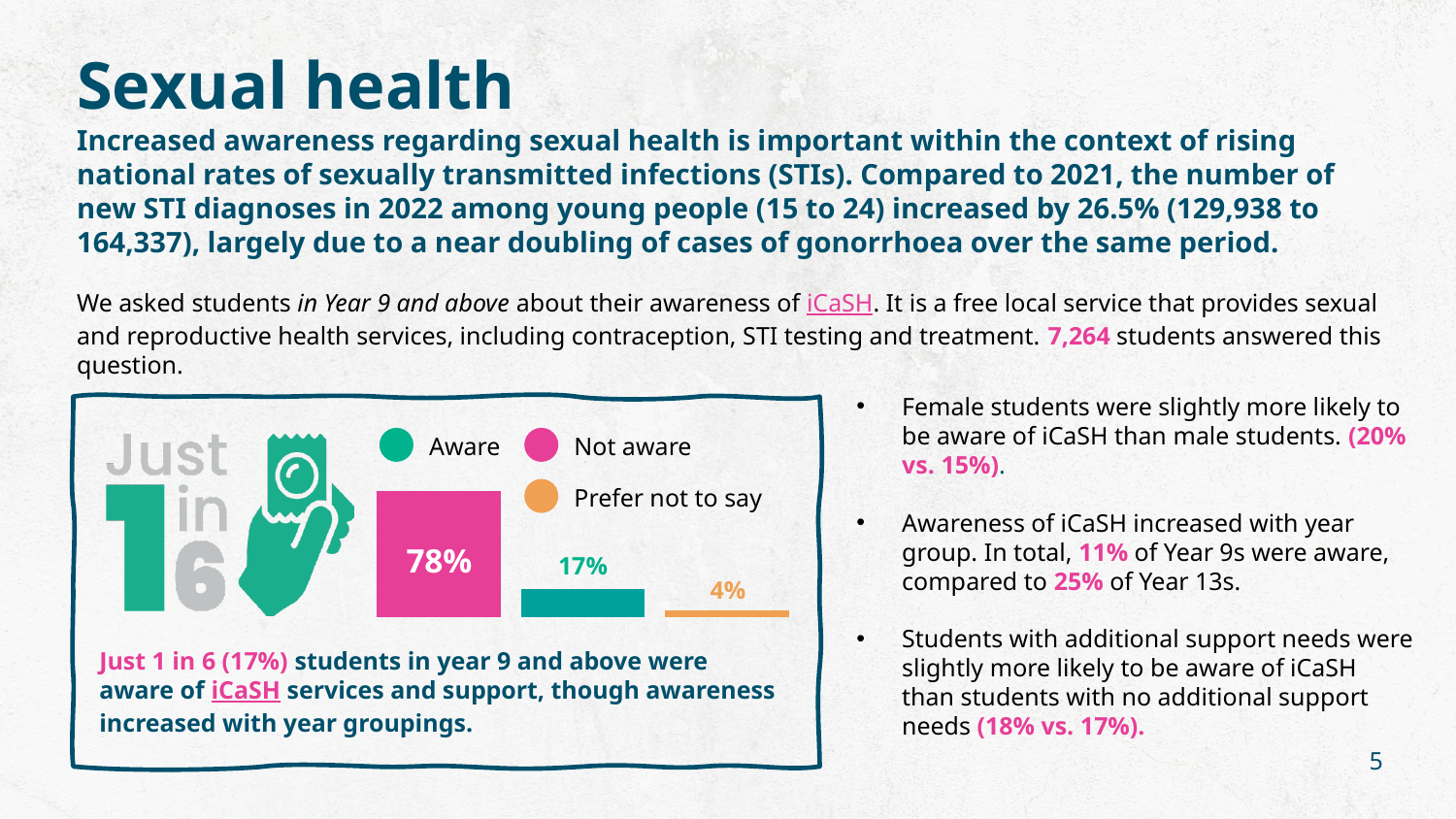
How many entries does the legend of the bar chart list? 3 What percentage of students answered 'Prefer not to say' in the bar chart? 4% How many categories are shown in the bar chart? 3 What percentage of students were aware of iCaSH according to the bar chart? 17% What percentage of students were not aware of iCaSH according to the bar chart? 78% What type of chart is used to show iCaSH awareness on the slide? Bar chart Which is larger in the bar chart, 'Aware' or 'Not aware'? Not aware Which category has the highest value in the bar chart? Not aware What colour represents 'Prefer not to say' in the bar chart legend? Orange Which category has the lowest value in the bar chart? Prefer not to say What is the difference between the 'Aware' and 'Prefer not to say' percentages in the bar chart? 13% What is the difference between the 'Not aware' and 'Aware' percentages in the bar chart? 61%